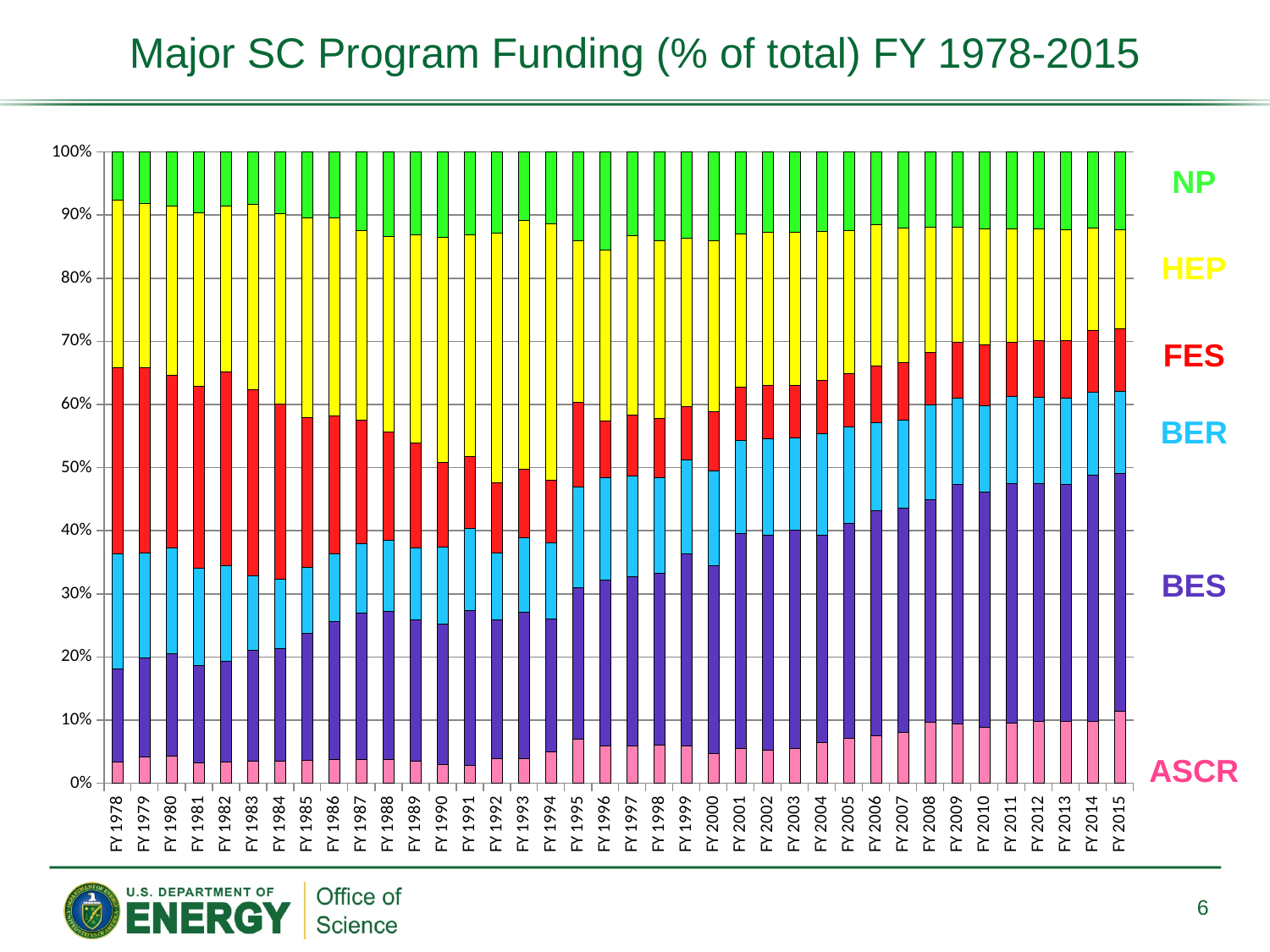
What is the title of the chart? Major SC Program Funding (% of total) FY 1978-2015 Which program series is shown at the bottom of each stacked bar? ASCR Is the BES share larger in FY 1978 or in FY 2015? FY 2015 Is the ASCR share for FY 1978 greater or less than 10%? less How many program series are labelled on the chart? 6 Does the ASCR share rise or fall from FY 1978 to FY 2015? rise How many fiscal years (bars) are plotted on the x axis? 38 What is the total of the stacked bar for FY 2000? 100% Which program has the largest share of funding in FY 2015? BES Which program has the smallest share of funding in FY 1978? ASCR Is the ASCR share for FY 2015 greater or less than 10%? greater What kind of chart is shown on the slide? stacked bar chart